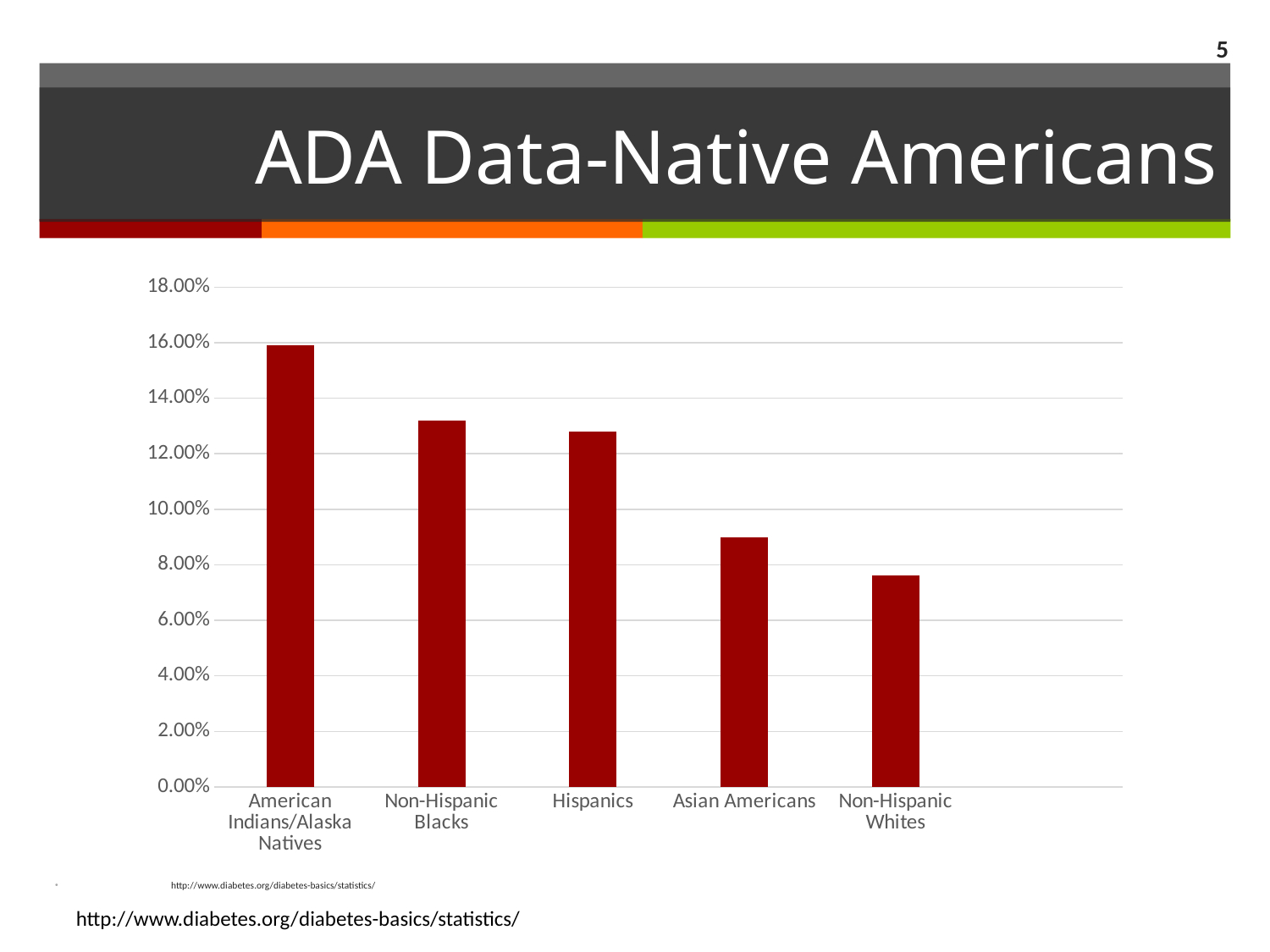
What kind of chart is shown on the slide? bar chart Is the value for Hispanics greater or less than 14.00%? less Is the value for Non-Hispanic Whites greater or less than 8.00%? less What is the title of the slide containing the chart? ADA Data-Native Americans Is the value for Non-Hispanic Blacks greater or less than 12.00%? greater Which category has the lowest value in the chart? Non-Hispanic Whites How many categories are plotted in the chart? 5 Which is larger, the value for Hispanics or the value for Asian Americans? Hispanics Do the values rise or fall moving from left to right across the categories? fall Which category has the highest value in the chart? American Indians/Alaska Natives